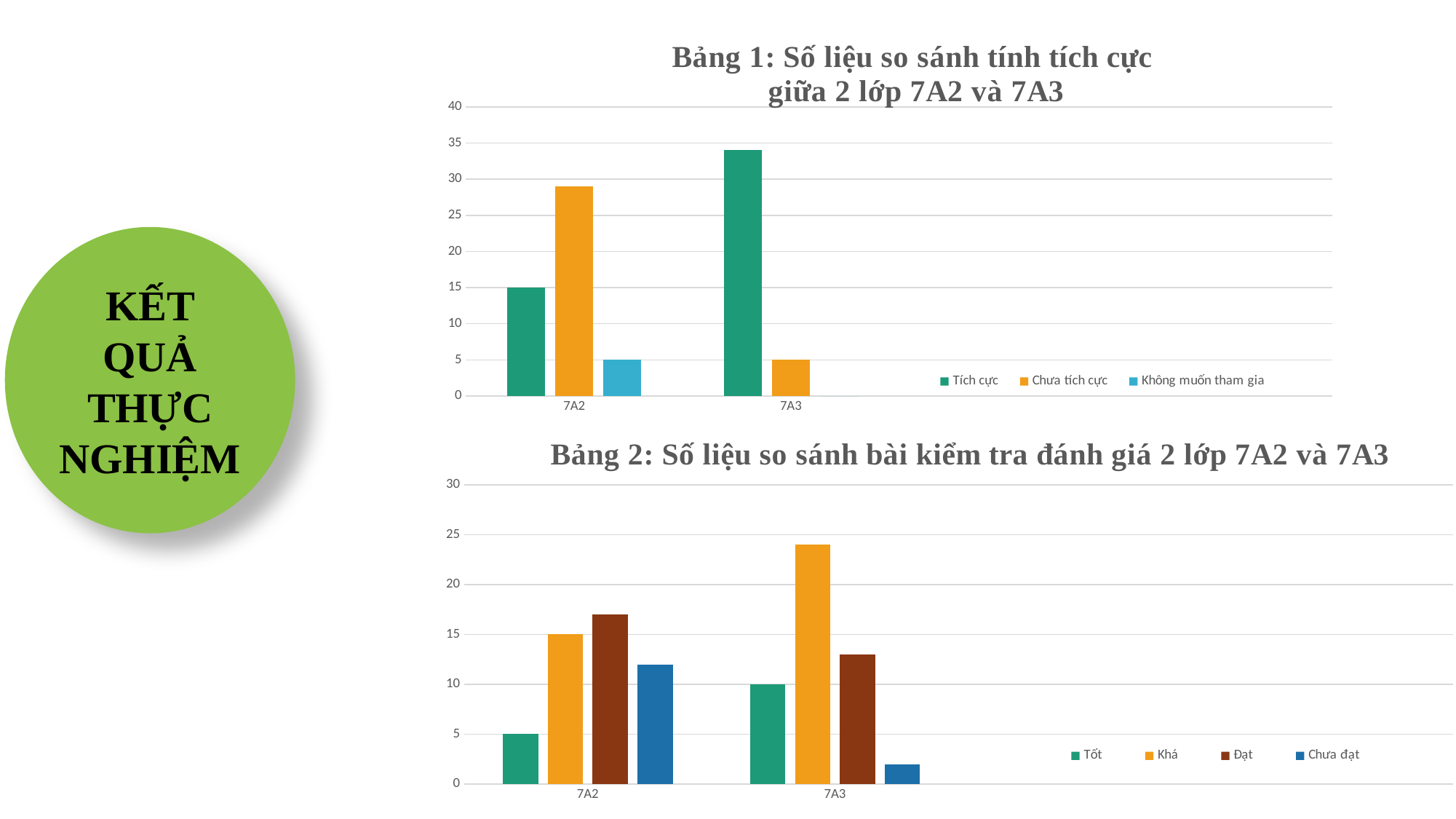
In the chart 'Bảng 2', which series has the highest value for 7A3? Khá In the chart 'Bảng 2: Số liệu so sánh bài kiểm tra đánh giá 2 lớp 7A2 và 7A3', what is the value of 'Tốt' for 7A2? 5 What type of chart is 'Bảng 2'? Bar chart In the chart 'Bảng 1: Số liệu so sánh tính tích cực giữa 2 lớp 7A2 và 7A3', what is the value of 'Tích cực' for 7A2? 15 In the chart 'Bảng 1', how many series does the legend list? 3 In the chart 'Bảng 1', is the value of 'Chưa tích cực' for 7A2 greater or less than 25? greater In the chart 'Bảng 2', what is the value of 'Khá' for 7A2? 15 In the chart 'Bảng 1', is the value of 'Tích cực' for 7A3 greater or less than 30? greater In the chart 'Bảng 1', which class has the higher 'Tích cực' value? 7A3 In the chart 'Bảng 2', what is the value of 'Tốt' for 7A3? 10 In the chart 'Bảng 2', is the value of 'Khá' for 7A3 greater or less than 20? greater In the chart 'Bảng 1', what is the value of 'Chưa tích cực' for 7A3? 5